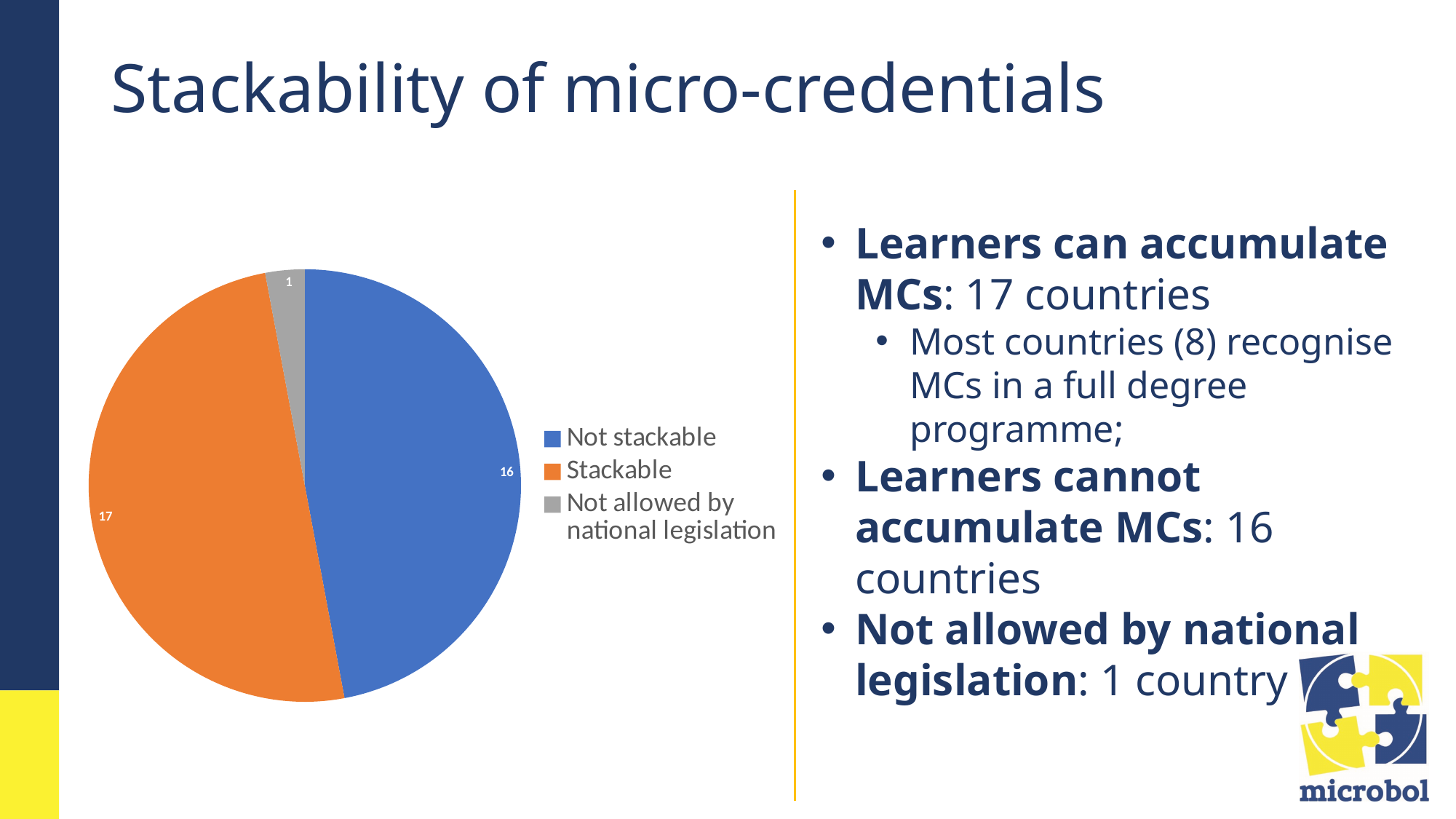
What is the value for the Stackable slice? 17 What share of the pie does the Stackable slice represent? 50% Which category has the smallest slice in the pie chart? Not allowed by national legislation Which category has the largest slice in the pie chart? Stackable What is the difference between the Stackable and Not stackable values? 1 How many slices does the pie chart have? 3 Which is larger, the Stackable value or the Not stackable value? Stackable What kind of chart is shown on the slide? pie chart What is the value for the Not allowed by national legislation slice? 1 What is the total of all slices in the pie chart? 34 What colour is the Stackable slice in the pie chart? orange What is the value for the Not stackable slice? 16